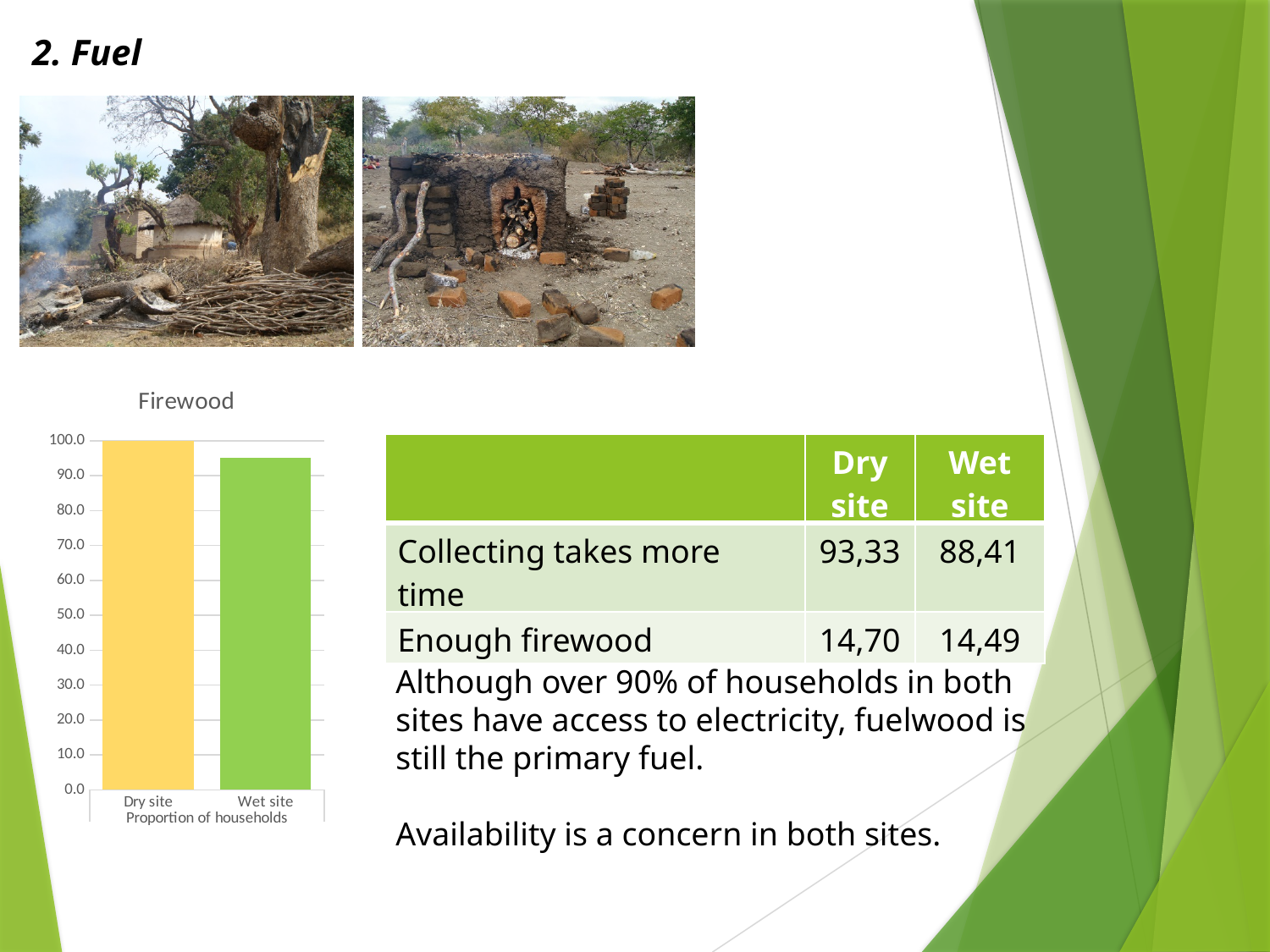
What is the highest value shown on the vertical axis of the Firewood chart? 100.0 Is the value for Dry site larger or smaller than the value for Wet site? larger Is the value for Wet site greater or less than 90.0? greater What is the label shown below the category axis of the Firewood chart? Proportion of households Which site has the higher bar in the Firewood chart? Dry site What is the title of the chart? Firewood Is the value for Wet site greater or less than 80.0? greater Which site has the lower bar in the Firewood chart? Wet site How many categories are plotted in the Firewood chart? 2 What is the value for Dry site in the Firewood chart? 100.0 What kind of chart is shown on the slide? bar chart